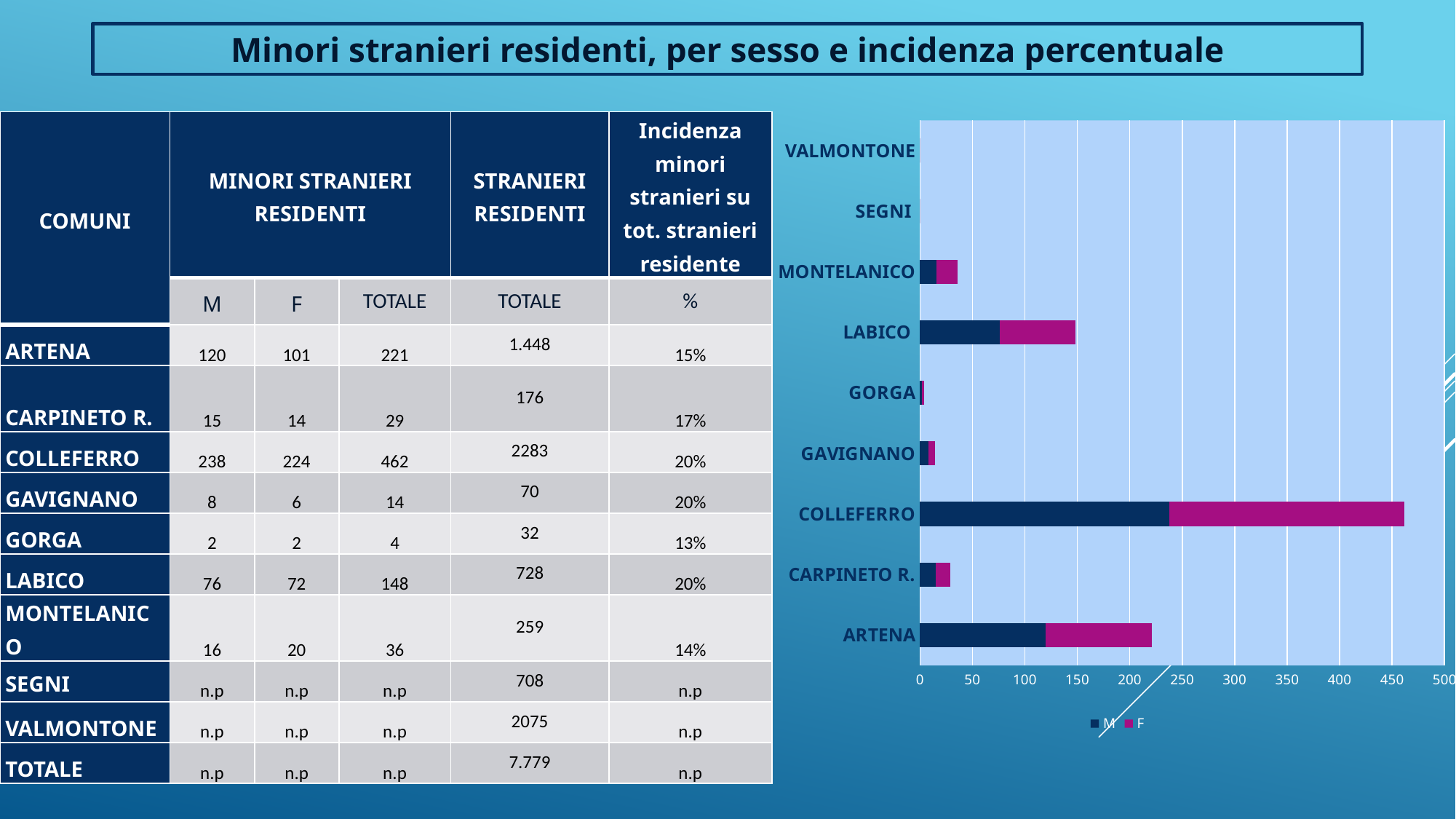
Which colour represents the F series in the chart? magenta Is the total bar length for COLLEFERRO greater or less than 400? greater How many series does the chart's legend list? 2 Which has the longer bar in the chart, CARPINETO R. or GAVIGNANO? CARPINETO R. What kind of chart is shown on the right of the slide? bar chart According to the slide, what is the M value plotted for COLLEFERRO? 238 Which comune has the longest bar in the chart? COLLEFERRO How many comuni (categories) are listed on the chart's vertical axis? 9 Is the total bar length for MONTELANICO greater or less than 50? less Is the total bar length for LABICO greater or less than 100? greater According to the slide, what is the total of the stacked bar (M + F) for ARTENA? 221 Which has the longer bar in the chart, LABICO or MONTELANICO? LABICO